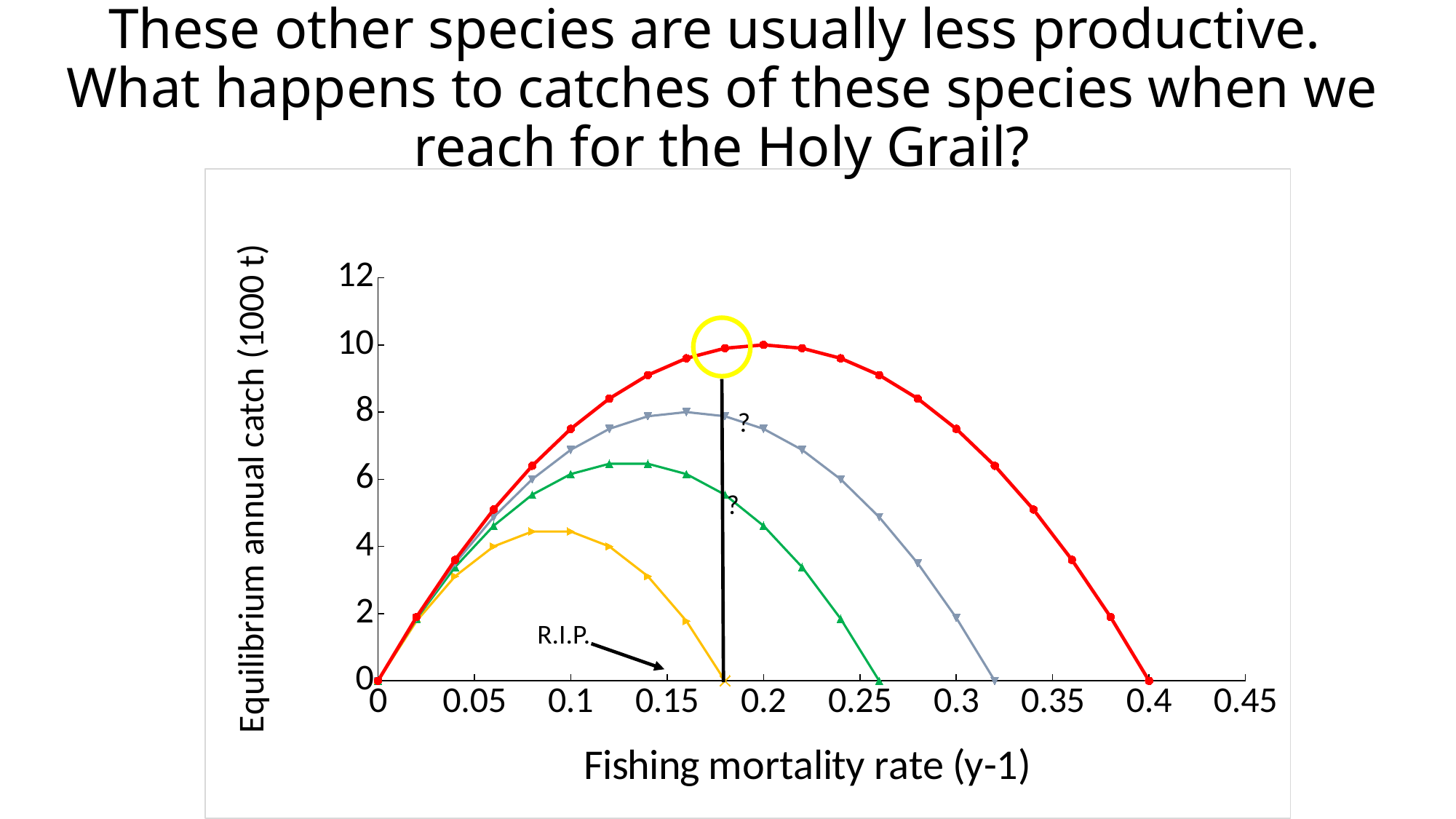
How many curves are plotted on the chart? 4 Is the peak value of the orange curve greater or less than 6? less Which curve has the lowest peak catch? the orange curve What is the value of the red curve at a fishing mortality rate of 0.4? 0 What is the title of the x axis? Fishing mortality rate (y-1) Does the red curve rise or fall as the fishing mortality rate increases from 0.2 to 0.4? fall At what fishing mortality rate does the red curve return to a catch of 0? 0.4 Which curve reaches the highest peak catch? the red curve What kind of chart is shown on the slide? line chart At a fishing mortality rate of 0.2, is the red curve or the grey curve higher? the red curve What is the title of the y axis? Equilibrium annual catch (1000 t) Is the value of the grey curve at a fishing mortality rate of 0.3 greater or less than 4? less